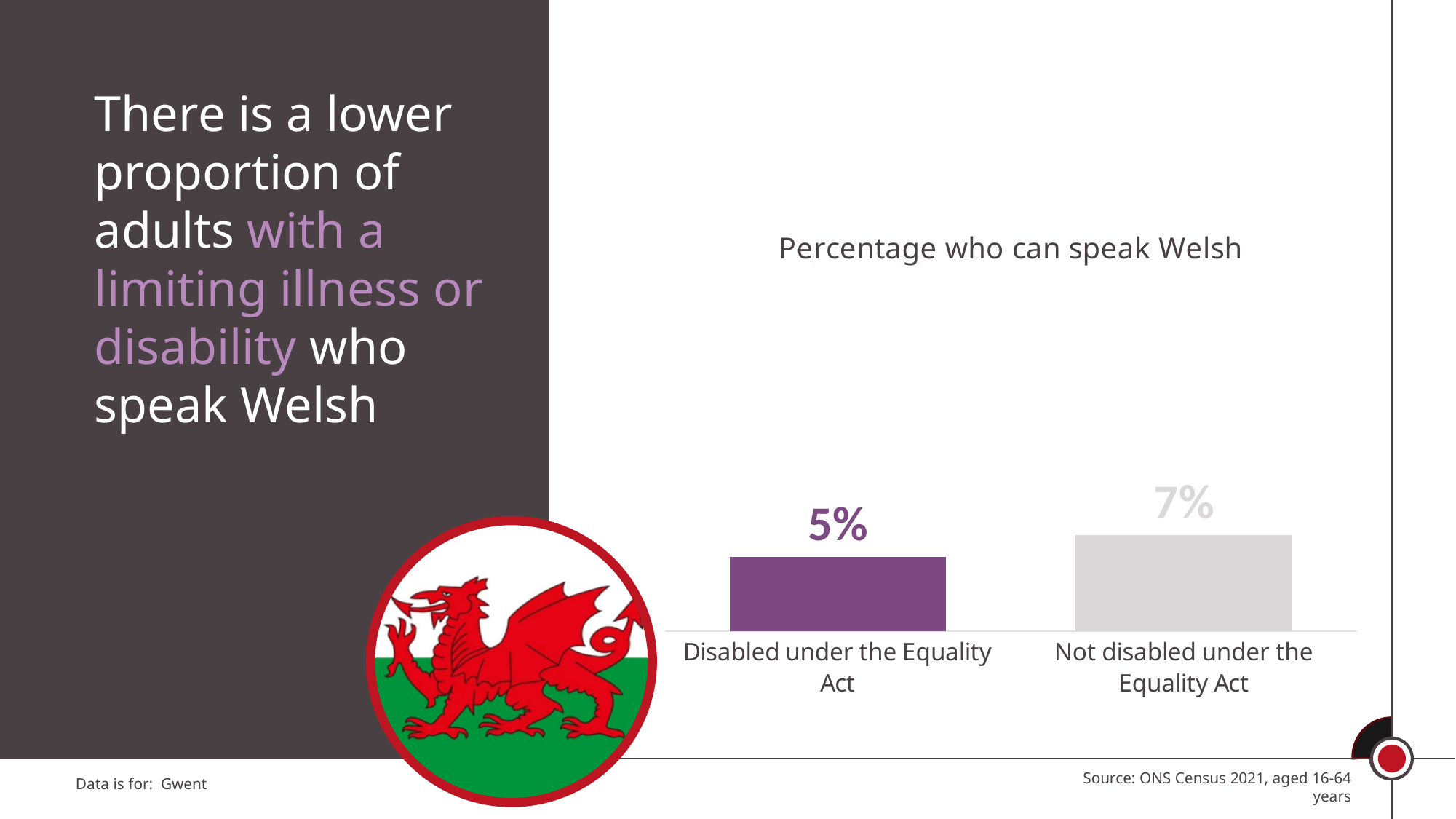
What is the title of the chart? Percentage who can speak Welsh What percentage of adults not disabled under the Equality Act can speak Welsh? 7% Is the percentage who can speak Welsh larger for those disabled or those not disabled under the Equality Act? Not disabled under the Equality Act What percentage of adults disabled under the Equality Act can speak Welsh? 5% What kind of chart is shown on the slide? Bar chart Which area does the data on the slide cover? Gwent How many categories are shown in the chart? 2 Which category has the higher percentage who can speak Welsh? Not disabled under the Equality Act What colour is the bar for adults disabled under the Equality Act? Purple What is the difference in percentage points between the two categories shown in the chart? 2 percentage points Which category has the lower percentage who can speak Welsh? Disabled under the Equality Act